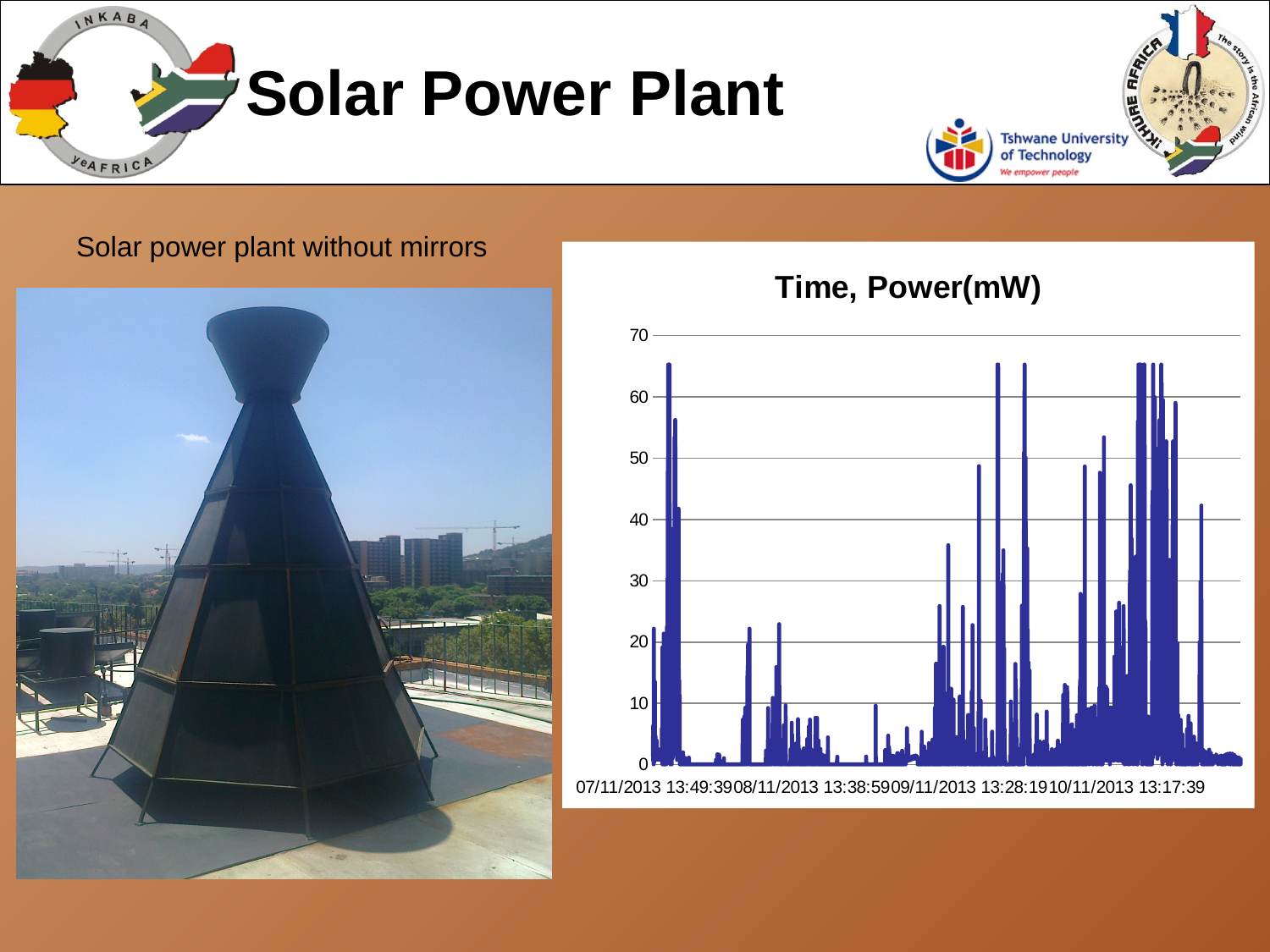
What is the last date-time label on the x axis of the chart? 10/11/2013 13:17:39 Is the highest peak in the chart greater or less than 70? less What is the first date-time label on the x axis of the chart? 07/11/2013 13:49:39 What is the highest value shown on the vertical axis of the chart? 70 Is the highest peak in the chart greater or less than 60? greater What is the title of the chart on the slide? Time, Power(mW) How many date-time labels are printed along the x axis of the chart? 4 Is the lowest value plotted in the chart greater or less than 10? less What kind of chart is shown on the slide? line chart What is the lowest value shown on the vertical axis of the chart? 0